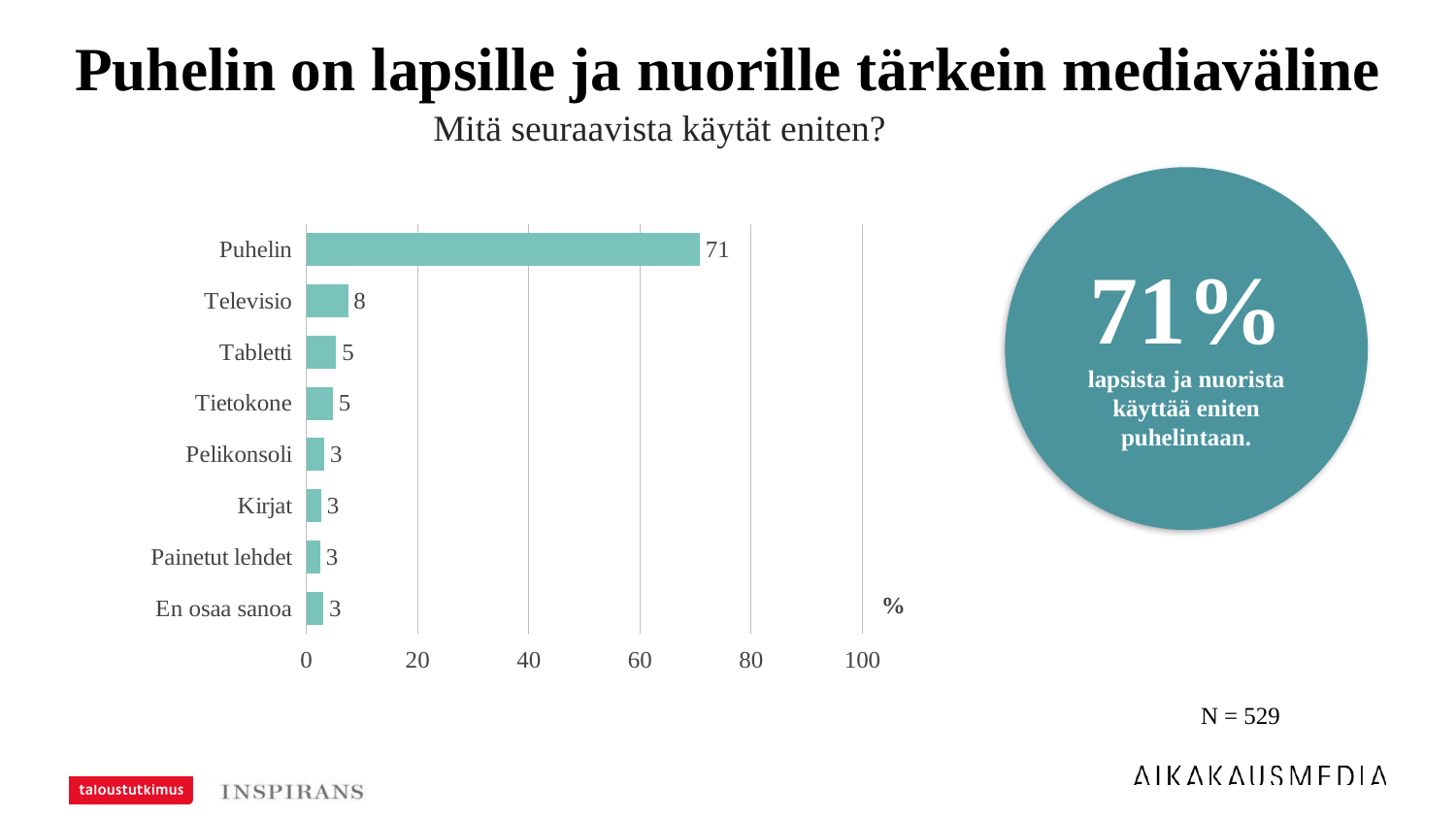
How many categories are shown in the chart? 8 What is the value for Puhelin? 71 Which category has the highest value? Puhelin What is the value for Pelikonsoli? 3 What kind of chart is shown on the slide? bar chart Which is larger, the value for Televisio or the value for Tabletti? Televisio Is the value for Puhelin greater or less than 60? greater What is the difference between the values for Puhelin and Televisio? 63 What is the value for Televisio? 8 What is the value for Tabletti? 5 What question is shown as the chart's subtitle? Mitä seuraavista käytät eniten? What is the difference between the values for Televisio and Tietokone? 3